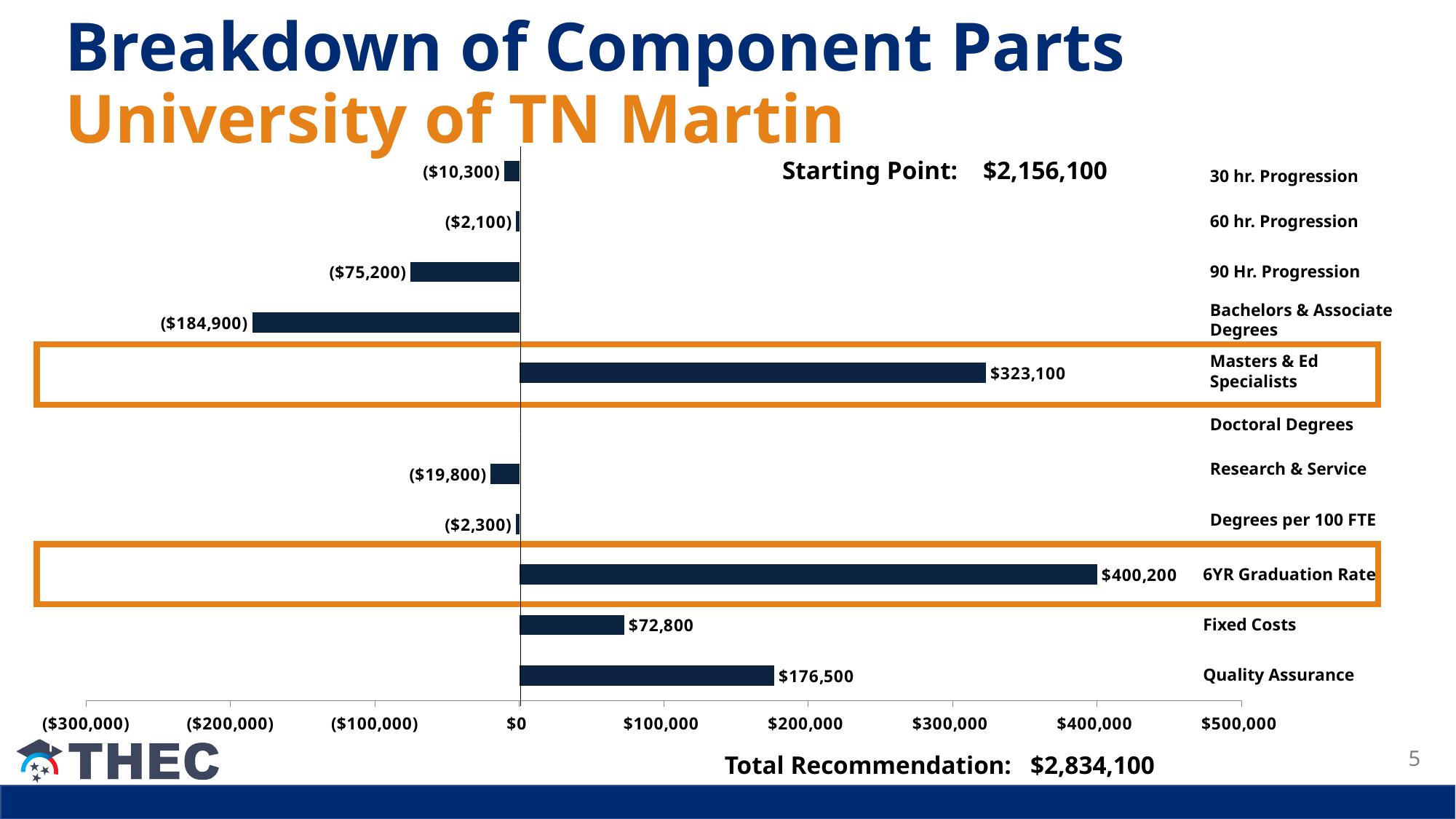
How many categories are listed on the chart? 11 What is the value for Masters & Ed Specialists? $323,100 What kind of chart is shown on the slide? Bar chart What is the value for 6YR Graduation Rate? $400,200 Which category has the lowest value? Bachelors & Associate Degrees Which category has the highest value? 6YR Graduation Rate What is the value for Bachelors & Associate Degrees? ($184,900) What is the difference between the values for 6YR Graduation Rate and Masters & Ed Specialists? $77,100 What is the difference between the values for Quality Assurance and Fixed Costs? $103,700 Which is larger, the value for Quality Assurance or the value for Fixed Costs? Quality Assurance Is the value for Quality Assurance greater or less than $200,000? less What is the value for Fixed Costs? $72,800